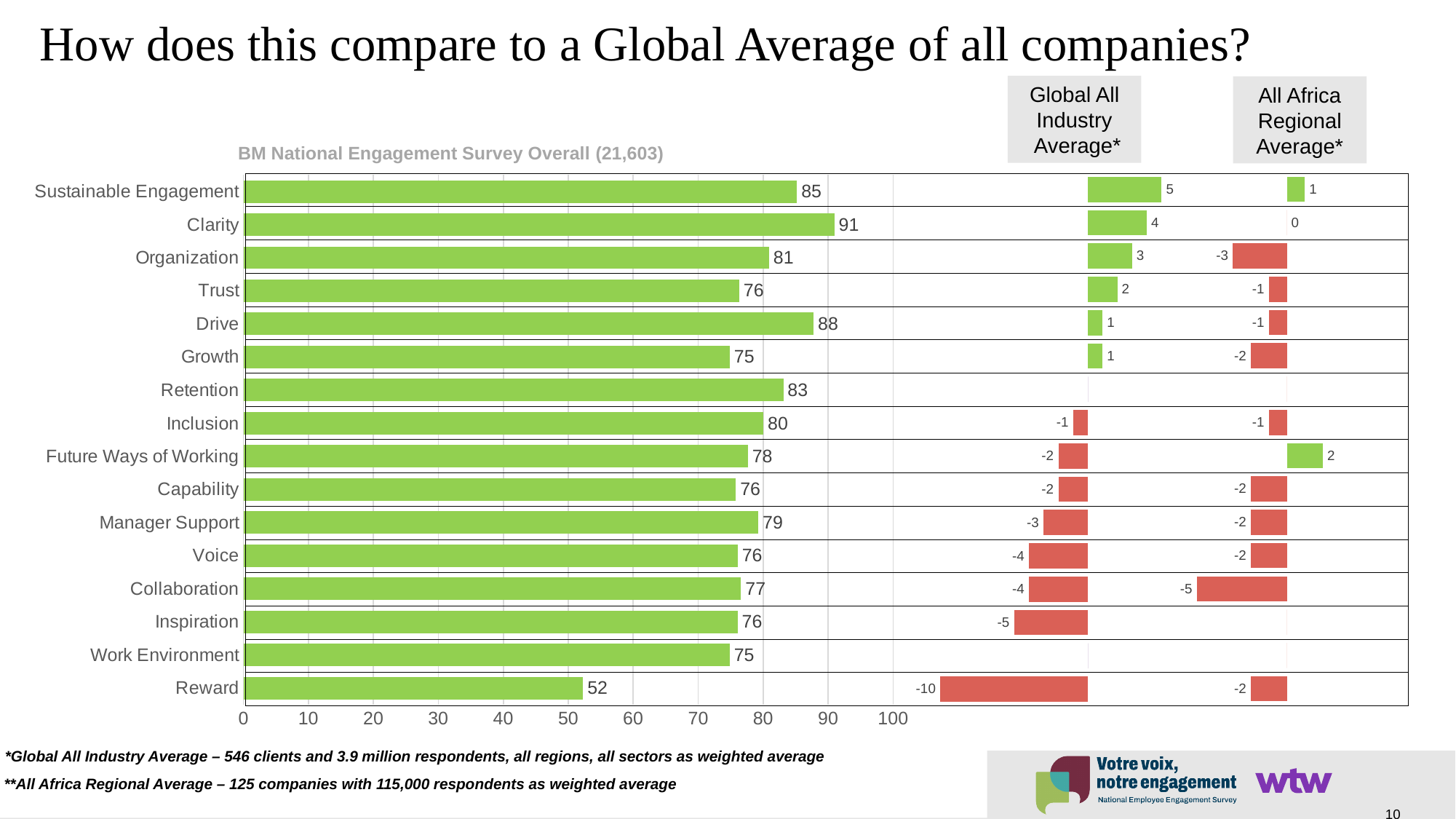
What is the title of the main bar chart on the slide? BM National Engagement Survey Overall (21,603) In the All Africa Regional Average column, what is the value shown for Collaboration? -5 In the Global All Industry Average column, what is the value shown for Reward? -10 What kind of chart is the BM National Engagement Survey Overall chart? Bar chart In the Global All Industry Average column, what is the value shown for Sustainable Engagement? 5 In the BM National Engagement Survey Overall chart, which is larger, the value for Retention or the value for Inclusion? Retention In the BM National Engagement Survey Overall chart, what is the value for Clarity? 91 How many categories are shown in the BM National Engagement Survey Overall chart? 16 In the BM National Engagement Survey Overall chart, which category has the highest value? Clarity In the BM National Engagement Survey Overall chart, which category has the lowest value? Reward In the BM National Engagement Survey Overall chart, what is the difference between the values for Drive and Growth? 13 In the BM National Engagement Survey Overall chart, what is the value for Reward? 52